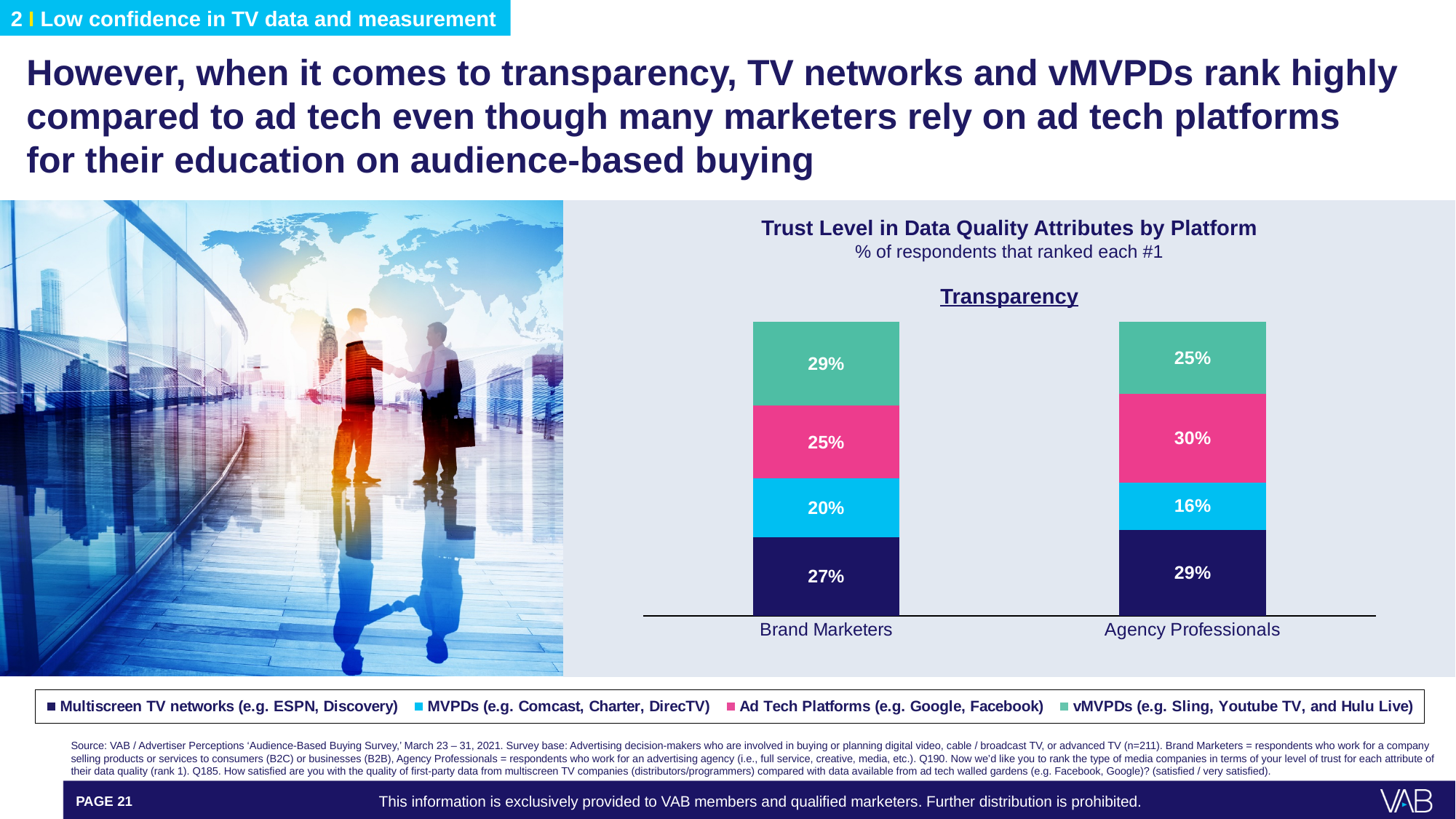
How many respondent groups (categories) are shown on the x axis? 2 What is the value for Multiscreen TV networks among Agency Professionals? 29% What percentage of Brand Marketers ranked vMVPDs #1 for transparency? 29% What is the subtitle under the chart title 'Trust Level in Data Quality Attributes by Platform'? % of respondents that ranked each #1 Which platform has the lowest value among Agency Professionals? MVPDs (e.g. Comcast, Charter, DirecTV) How many series does the legend list? 4 Which platform has the highest value among Brand Marketers? vMVPDs (e.g. Sling, Youtube TV, and Hulu Live) What kind of chart is shown? Stacked bar chart Which is larger: the Ad Tech Platforms value for Brand Marketers or for Agency Professionals? Agency Professionals What is the difference between the MVPDs value for Brand Marketers and for Agency Professionals? 4% What is the value for MVPDs among Brand Marketers? 20% What percentage of Agency Professionals ranked Ad Tech Platforms #1 for transparency? 30%